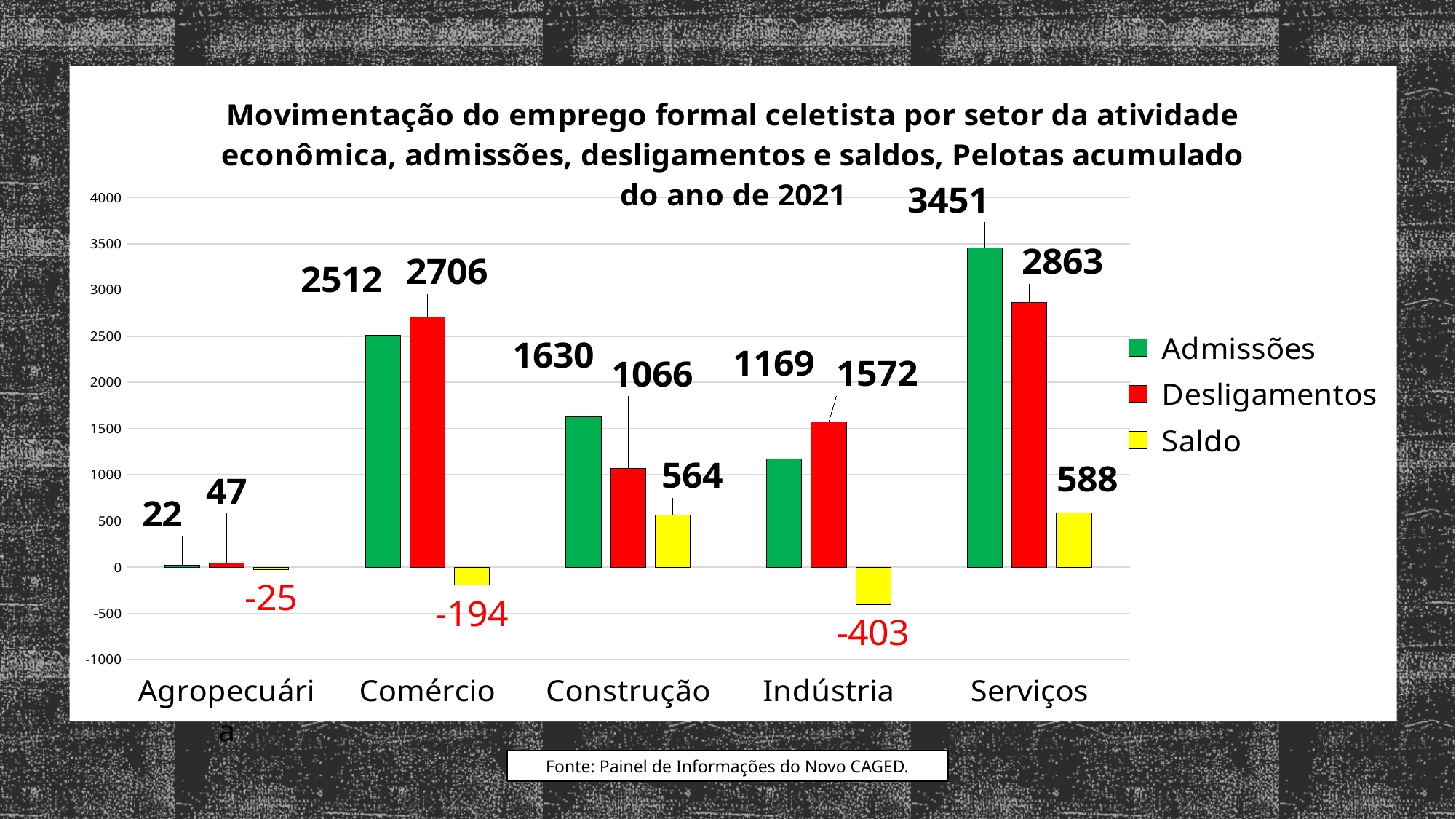
How many sectors are shown on the x axis? 5 How many series does the legend list? 3 Which sector has the highest Admissões value? Serviços What kind of chart is shown on the slide? Bar chart What is the Saldo value for Indústria? -403 What is the Desligamentos value for Comércio? 2706 Which is larger for Indústria, Admissões or Desligamentos? Desligamentos What is the difference between Admissões and Desligamentos for Construção? 564 What is the Admissões value for Serviços? 3451 What colour represents the Saldo series in the legend? Yellow Which sector has the lowest Saldo value? Indústria What is the Saldo value for Construção? 564